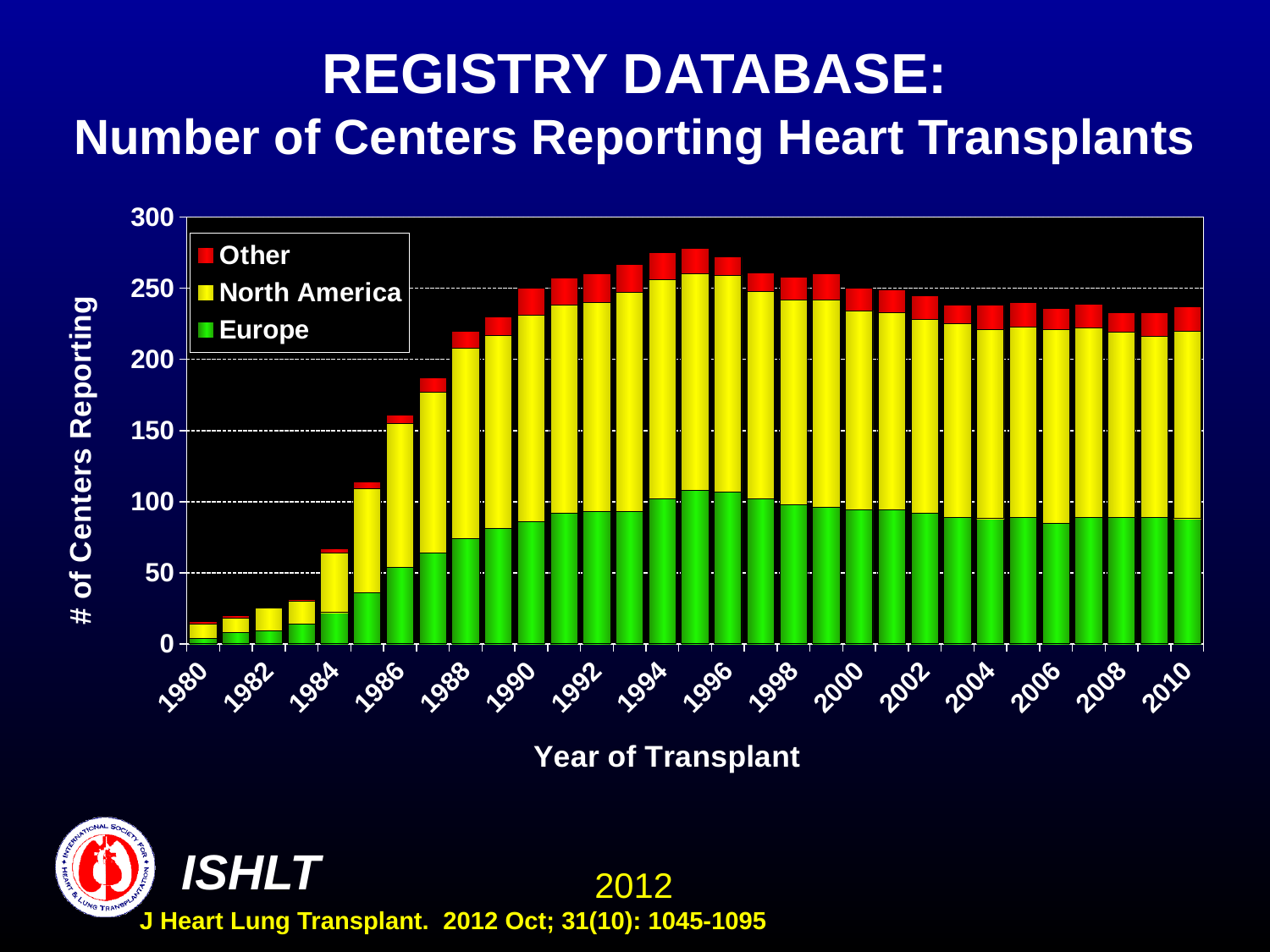
How many years (bars) are plotted on the chart? 31 Which series are listed in the legend? Other, North America, Europe Do the total numbers of centers reporting rise or fall from 1980 to 1995? rise Which year has the lowest total number of centers reporting? 1980 How many series does the legend list? 3 Which year has a larger total number of centers reporting, 1985 or 1990? 1990 What is the label of the x axis? Year of Transplant Is the number of Europe centers reporting in 2010 greater or less than 100? less Is the total number of centers reporting in 1988 greater or less than 200? greater What kind of chart is shown on the slide? bar chart Is the total number of centers reporting in 1995 greater or less than 250? greater